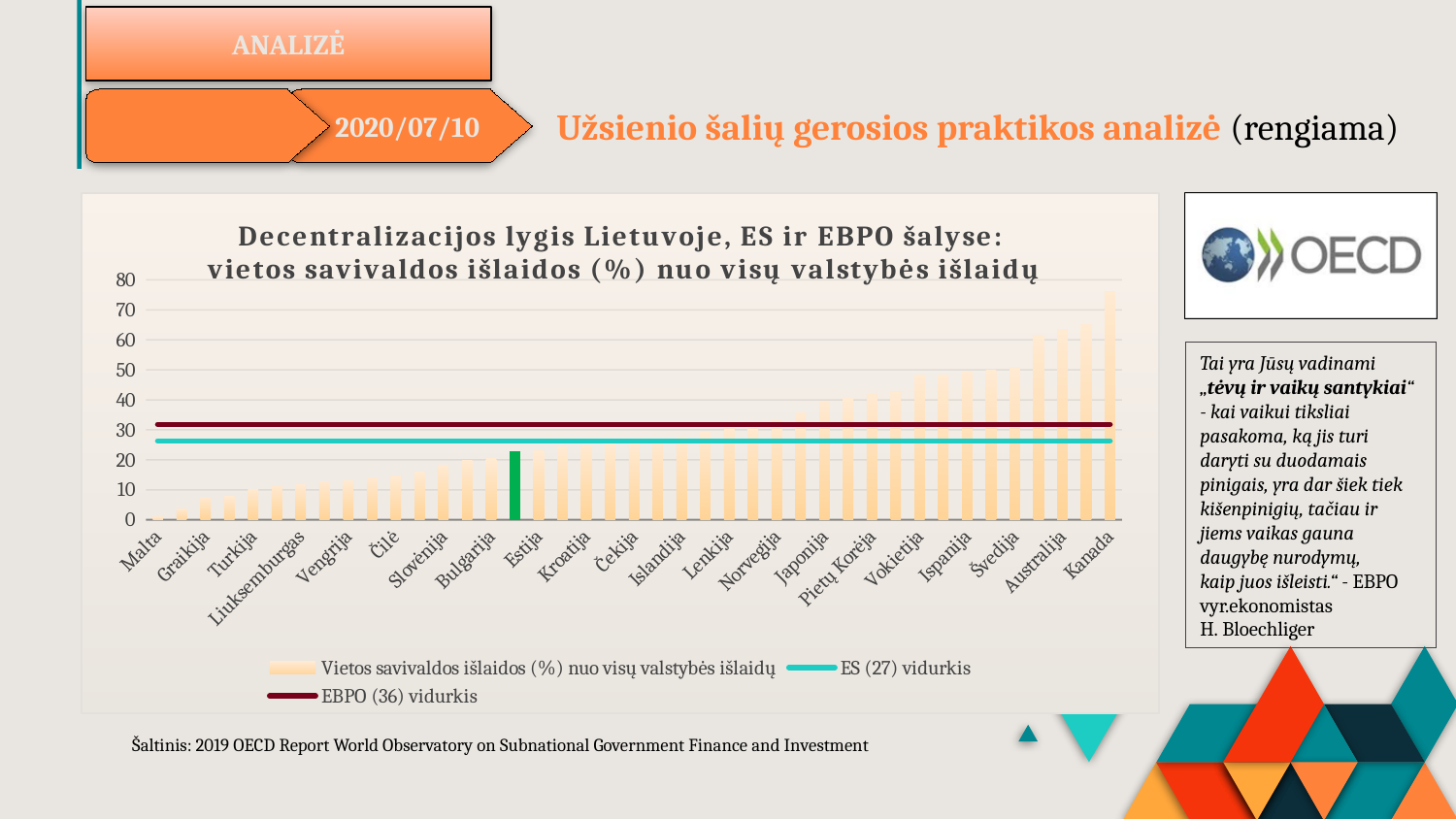
What kind of chart is shown on the slide? combination bar and line chart Is the value for Malta greater or less than 10? less Is the value for Turkija greater or less than 20? less How many series does the legend list? 3 Which horizontal line is higher, ES (27) vidurkis or EBPO (36) vidurkis? EBPO (36) vidurkis Is the ES (27) vidurkis line greater or less than 30? less Which country has the lowest value for local government expenditure (%) in the chart? Malta Which has a larger value, Australija or Graikija? Australija Which country has the highest value for local government expenditure (%) in the chart? Kanada Do the bar values rise or fall from left to right along the x axis? rise